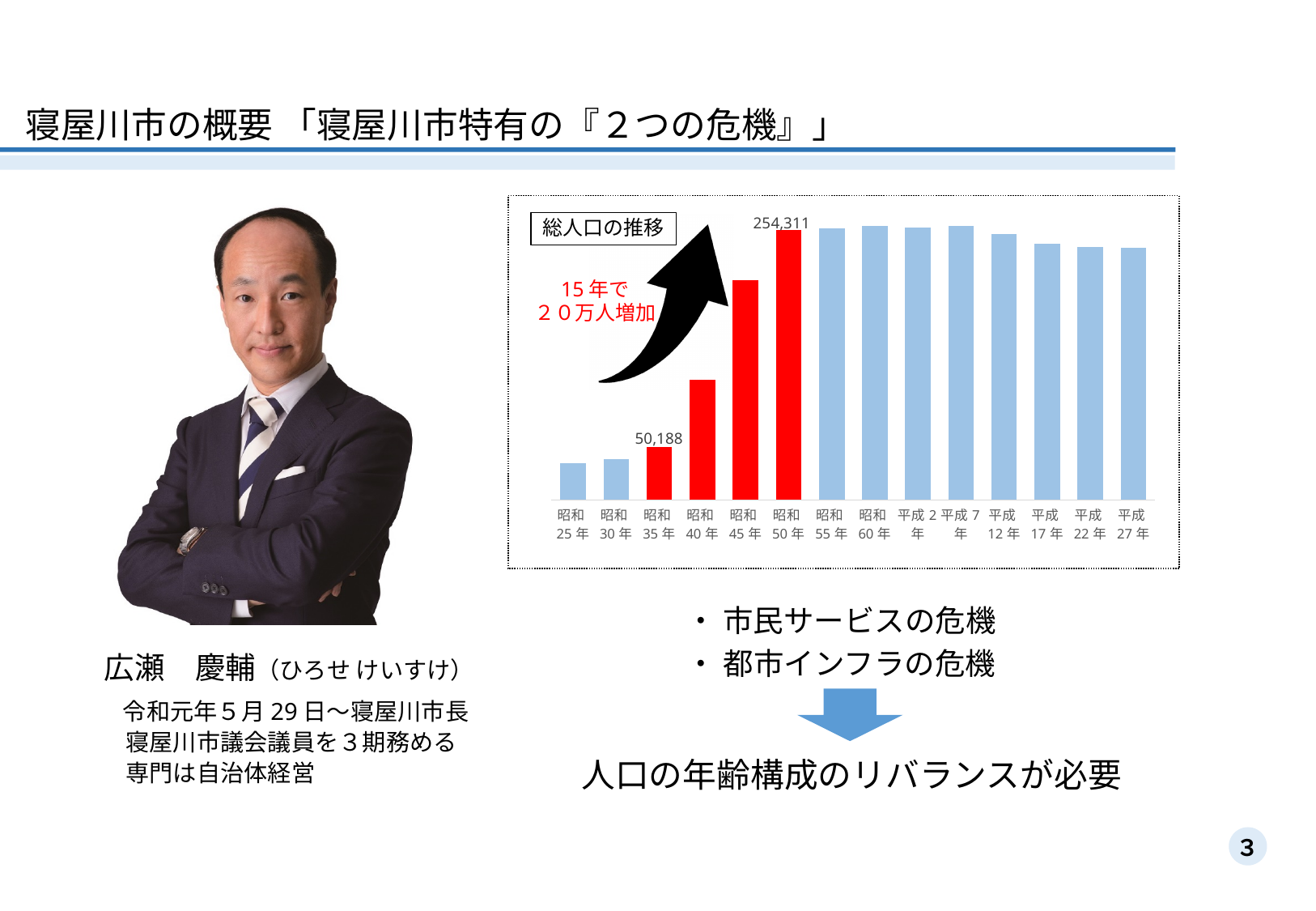
Which is larger, the value for 昭和45年 or the value for 昭和40年? 昭和45年 What kind of chart is shown on the slide? bar chart What is the difference between the values for 昭和50年 and 昭和35年? 204,123 Which is larger, the value for 平成27年 or the value for 昭和30年? 平成27年 Do the values rise or fall from 平成7年 to 平成27年? fall How many categories (years) are shown on the x axis? 14 What is the value shown for 昭和50年? 254,311 Do the values rise or fall from 昭和25年 to 昭和50年? rise What is the value shown for 昭和35年? 50,188 Which is larger, the value for 昭和40年 or the value for 昭和35年? 昭和40年 What is the title of the chart? 総人口の推移 Which years are highlighted with red bars? 昭和35年, 昭和40年, 昭和45年, 昭和50年